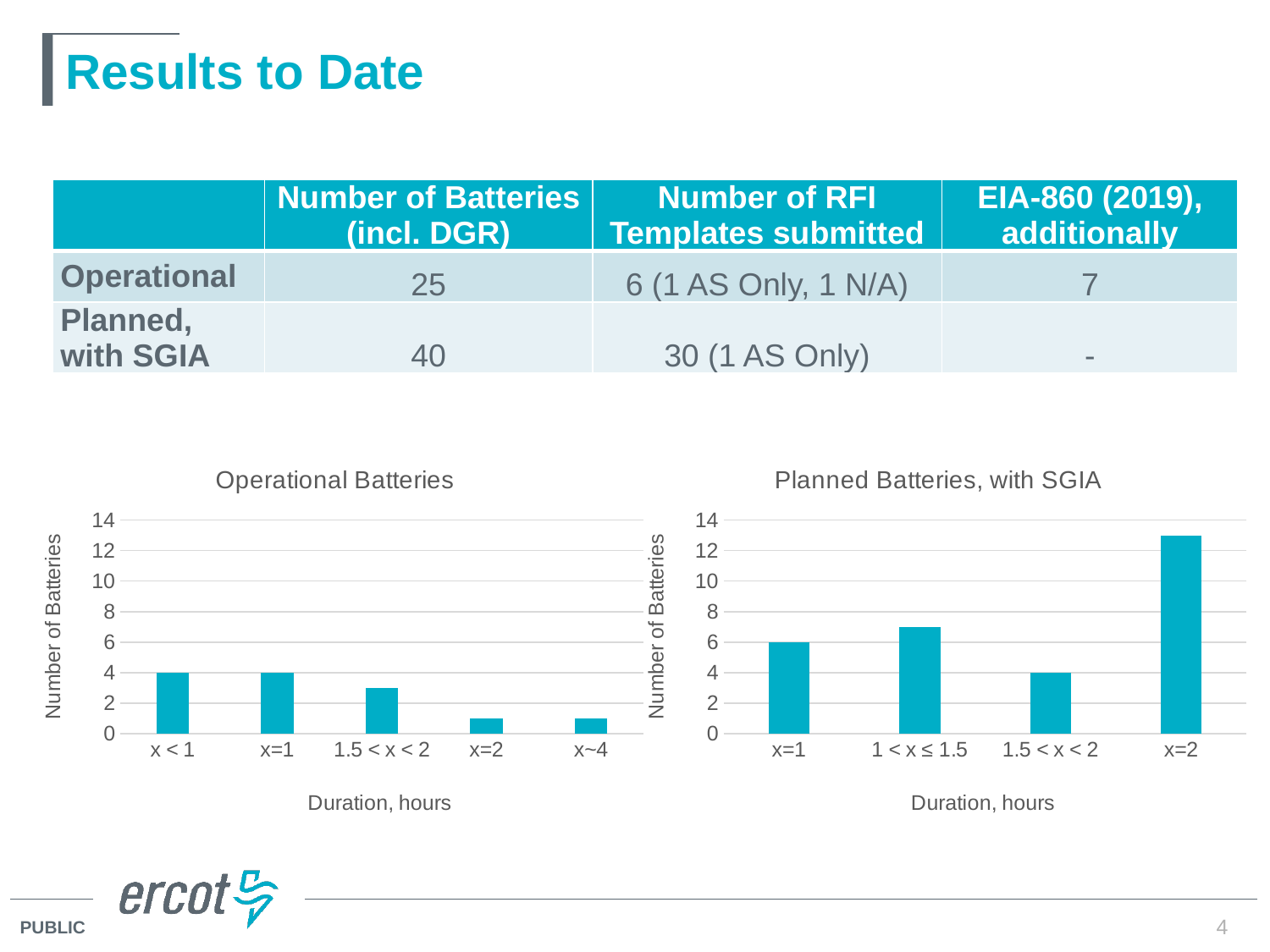
How many duration categories are shown in the Operational Batteries chart? 5 What type of chart is the Planned Batteries, with SGIA chart? Bar chart In the Planned Batteries, with SGIA chart, what is the number of batteries for the 1.5 < x < 2 category? 4 In the Planned Batteries, with SGIA chart, is the value for x=2 greater or less than 12? greater In the Planned Batteries, with SGIA chart, what is the difference between the number of batteries for x=1 and for 1.5 < x < 2? 2 In the Planned Batteries, with SGIA chart, which has more batteries: x=1 or x=2? x=2 In the Operational Batteries chart, is the value for x=2 greater or less than 2? less In the Planned Batteries, with SGIA chart, which duration category has the highest number of batteries? x=2 In the Planned Batteries, with SGIA chart, what is the number of batteries for the x=1 duration category? 6 In the Operational Batteries chart, what is the number of batteries for the x < 1 duration category? 4 In the Planned Batteries, with SGIA chart, is the value for 1 < x ≤ 1.5 greater or less than 6? greater In the Planned Batteries, with SGIA chart, which duration category has the lowest number of batteries? 1.5 < x < 2